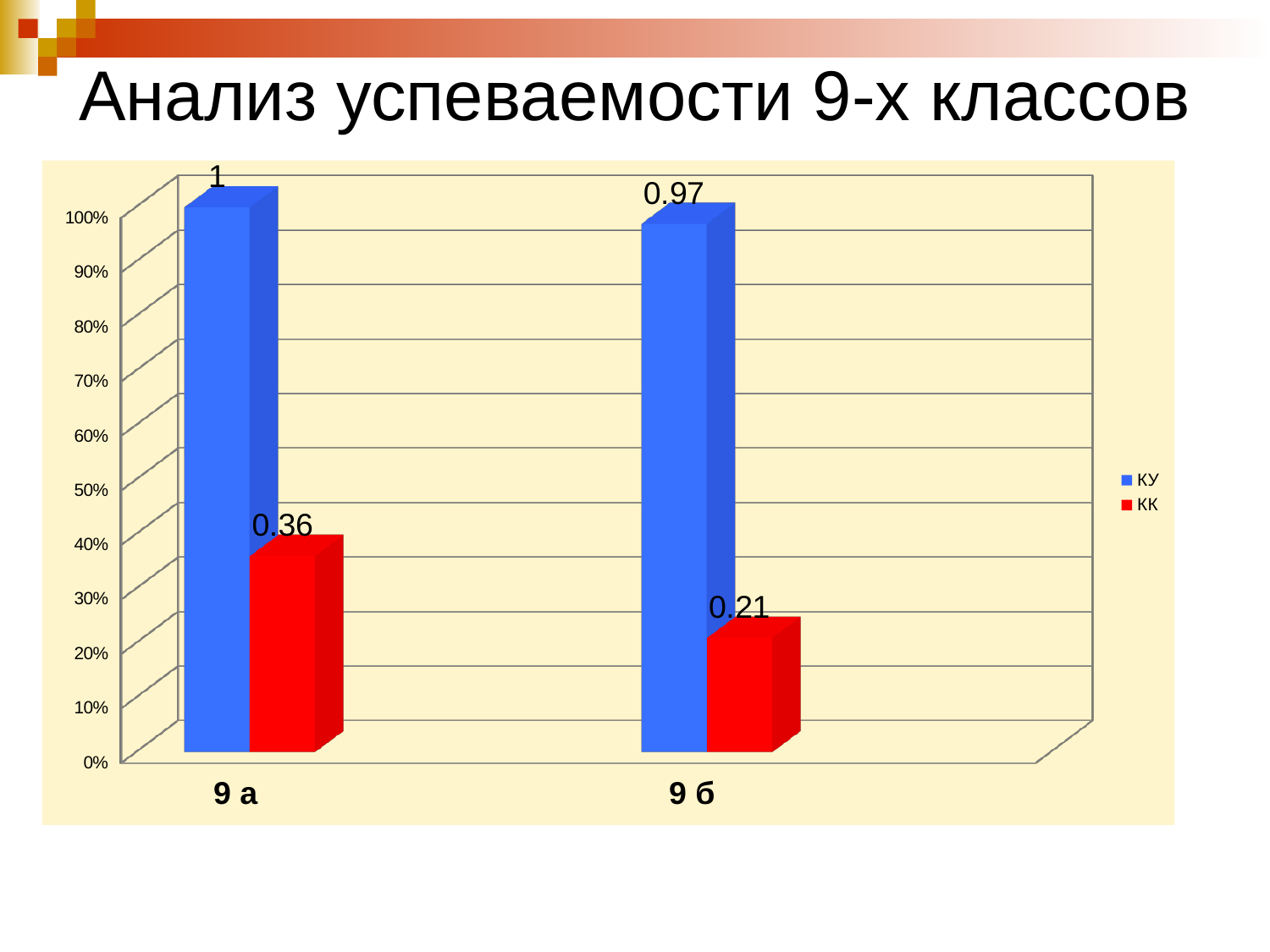
What type of chart is shown on the slide? bar chart What is the difference between the КК values for 9 а and 9 б? 0.15 What is the value of the КК series for class 9 б? 0.21 Which class has the lower КУ value? 9 б What is the value of the КК series for class 9 а? 0.36 How many series does the legend list? 2 What is the value of the КУ series for class 9 а? 1 Which class has the higher КК value? 9 а How many classes are shown on the x axis? 2 What is the difference between the КУ values for 9 а and 9 б? 0.03 Is the КК value for 9 б greater or less than 30%? less What is the value of the КУ series for class 9 б? 0.97